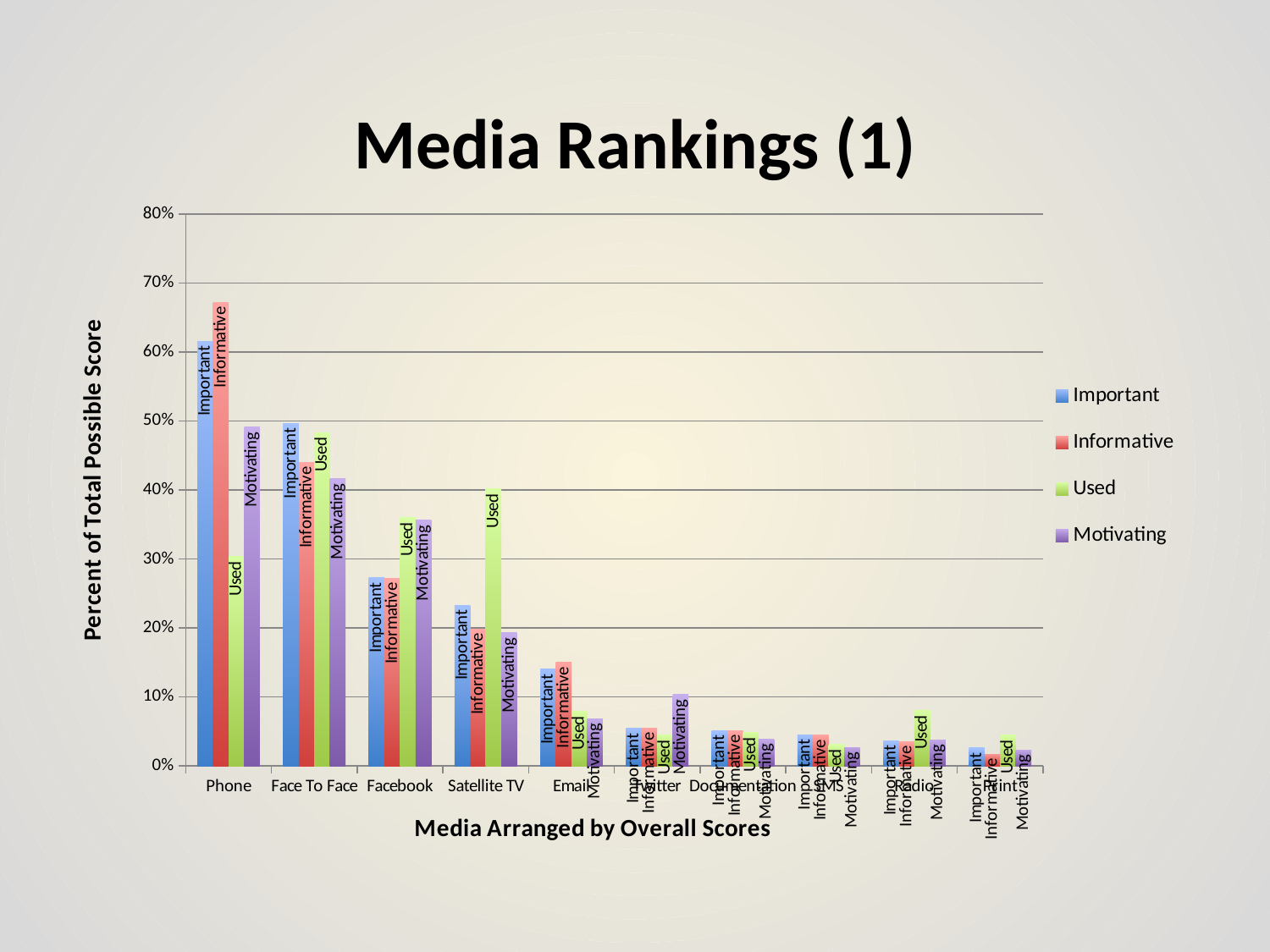
Is the Used value for Phone greater or less than 40%? less What kind of chart is shown on the slide? Bar chart How many media categories are shown on the x axis? 10 Do the Important values generally rise or fall moving from Phone to Print along the x axis? fall Which media has the highest Informative value? Phone What is the title of the vertical axis? Percent of Total Possible Score Is the Informative value for Phone greater or less than 60%? greater How many series does the legend list? 4 Which has the larger Important value, Phone or Face To Face? Phone Is the Used value for Satellite TV greater or less than 30%? greater For Satellite TV, which is larger, the Used value or the Important value? Used What is the title of the horizontal axis? Media Arranged by Overall Scores